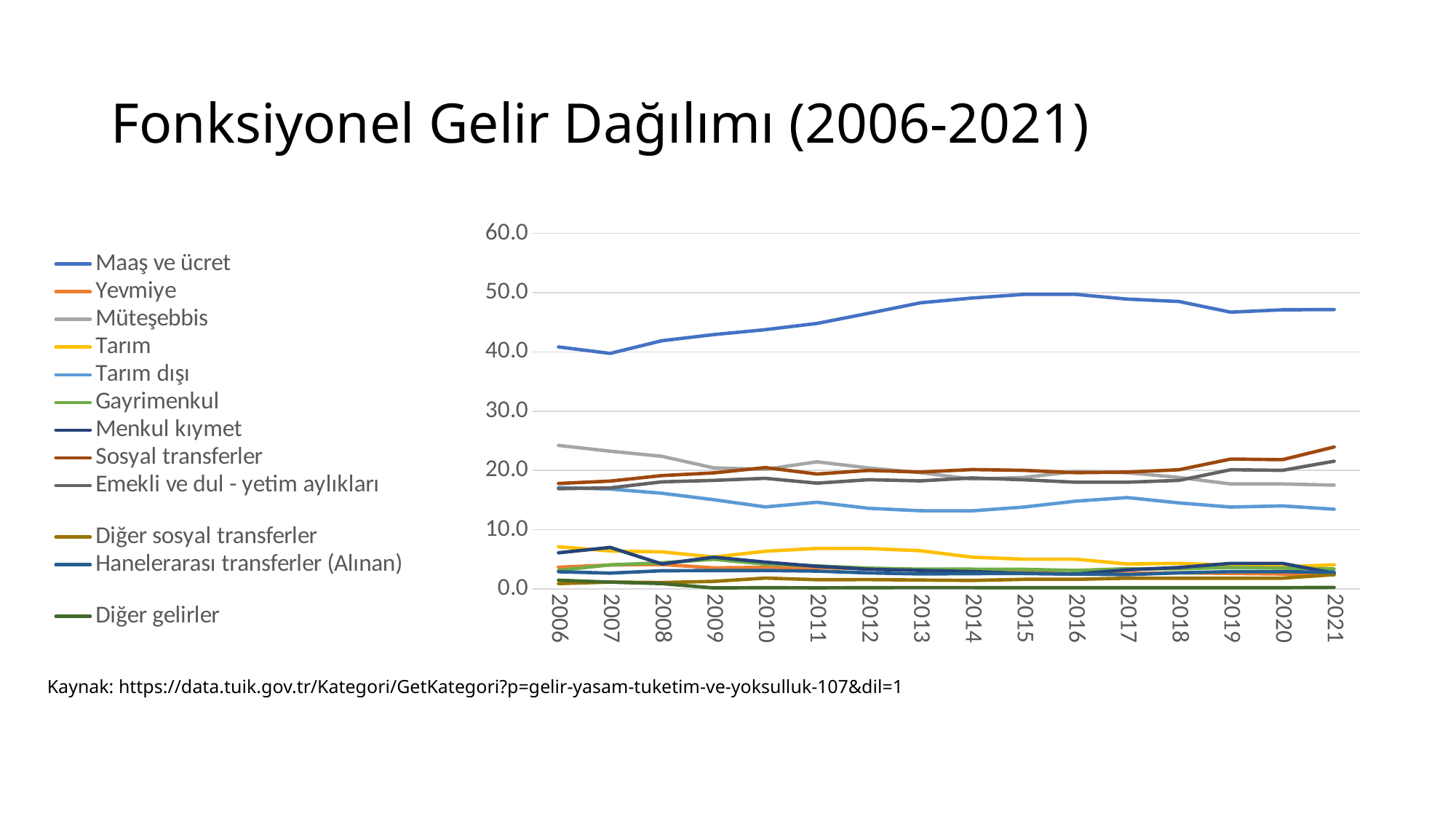
Is the value for Maaş ve ücret in 2007 greater or less than 50.0? less Which is larger in 2006, Müteşebbis or Tarım dışı? Müteşebbis How many years are shown along the x axis? 16 What kind of chart is shown on the slide? line chart Is the value for Sosyal transferler in 2021 greater or less than 20.0? greater Which is larger in 2021, Sosyal transferler or Müteşebbis? Sosyal transferler How many series does the legend list? 12 Is the value for Maaş ve ücret in 2015 greater or less than 40.0? greater What is the title of the slide? Fonksiyonel Gelir Dağılımı (2006-2021) Which series has the highest values throughout the chart? Maaş ve ücret Does the Maaş ve ücret series rise or fall between 2007 and 2015? rise